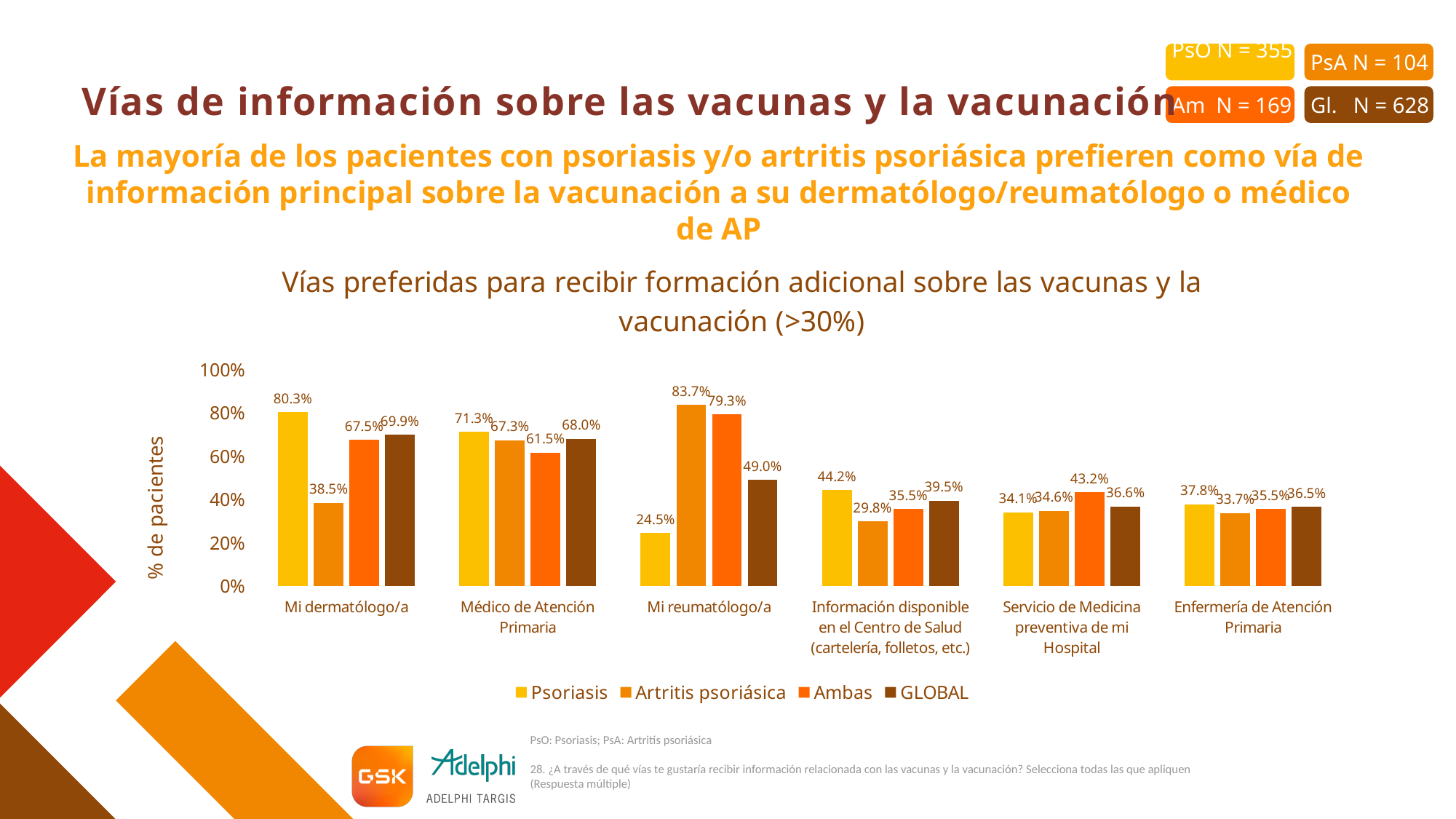
What is the GLOBAL value for 'Médico de Atención Primaria'? 68.0% What is the Artritis psoriásica value for 'Mi reumatólogo/a'? 83.7% What is the Psoriasis value for 'Mi dermatólogo/a'? 80.3% How many series does the legend list? 4 How many categories are shown on the x axis? 6 What is the title of the chart? Vías preferidas para recibir formación adicional sobre las vacunas y la vacunación (>30%) What is the Ambas value for 'Servicio de Medicina preventiva de mi Hospital'? 43.2% What type of chart is shown on the slide? bar chart Which category has the lowest Psoriasis value? Mi reumatólogo/a What is the difference between the Psoriasis and Artritis psoriásica values for 'Mi dermatólogo/a'? 41.8% Which category has the highest GLOBAL value? Mi dermatólogo/a For 'Mi reumatólogo/a', which is larger: the Ambas value or the GLOBAL value? Ambas